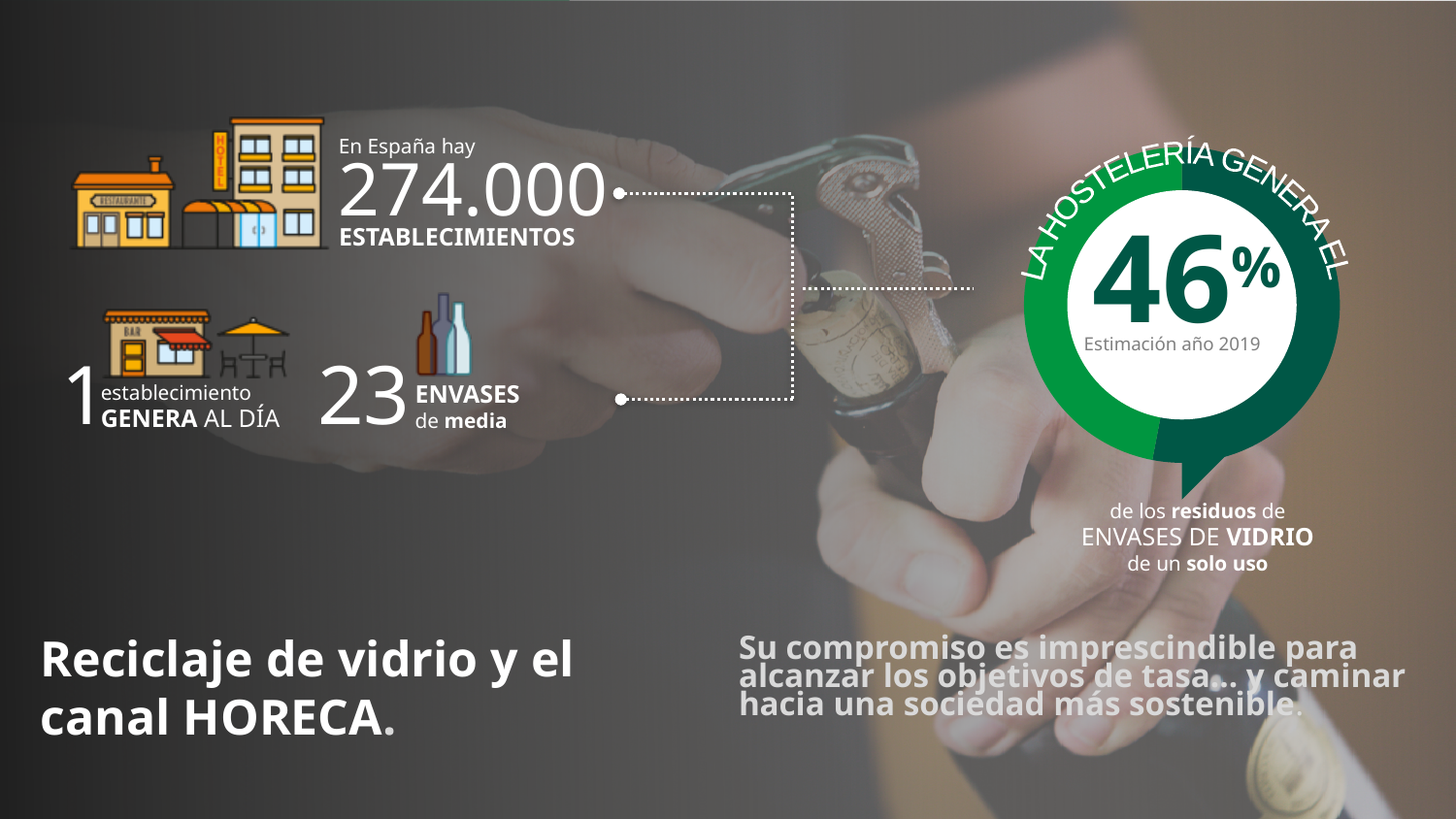
What text is written around the outside of the donut chart? LA HOSTELERÍA GENERA EL What year is the estimate in the donut chart for? 2019 What kind of chart is used to show the 46% figure? donut chart What percentage is shown in the centre of the donut chart? 46% According to the donut chart, what share of single-use glass packaging waste is not generated by the hospitality sector? 54% How many establishments does the slide say there are in Spain? 274.000 Is the value shown in the donut chart greater or less than 50%? less How many containers (envases) does one establishment generate per day on average, according to the slide? 23